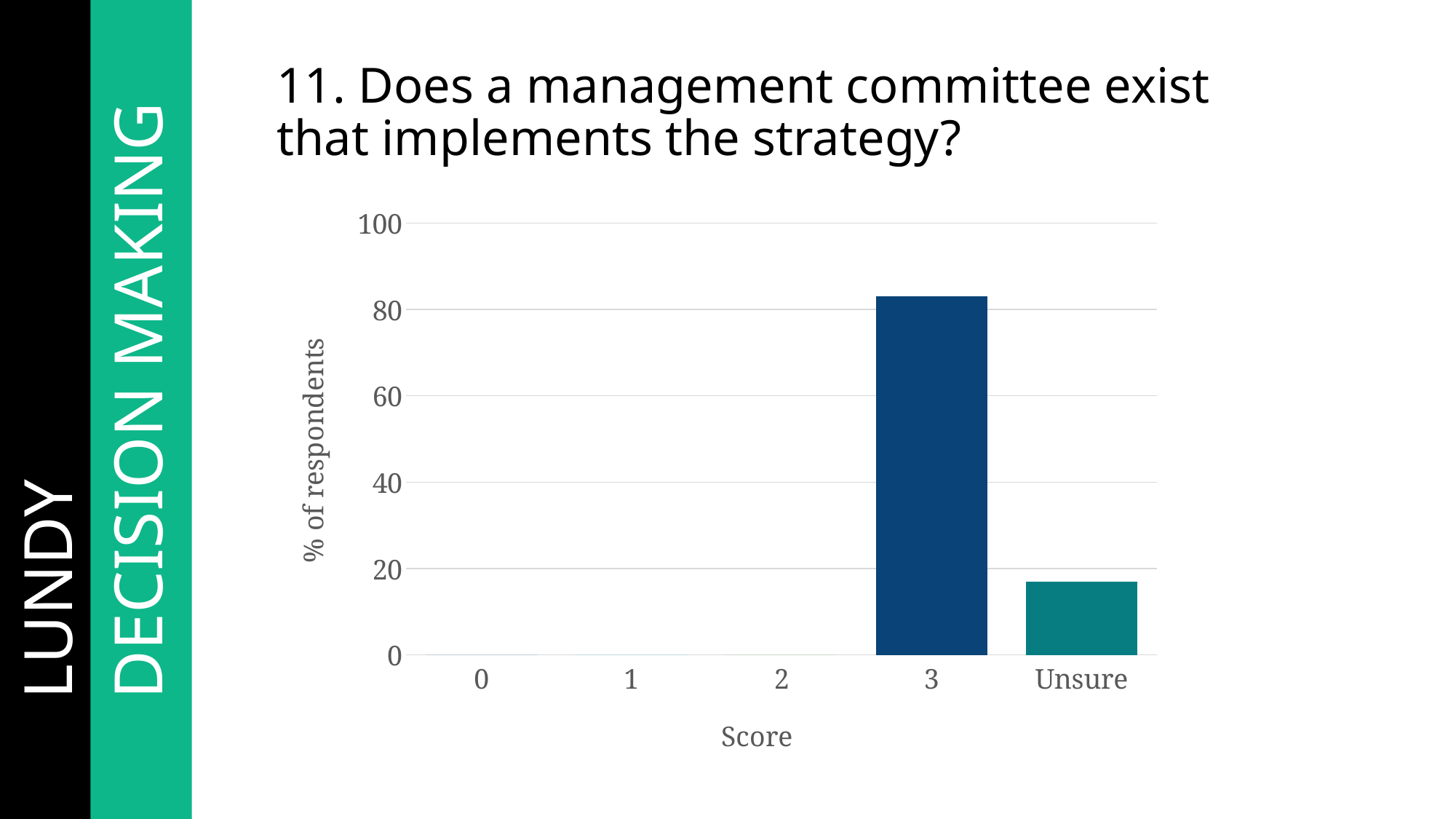
Is the value for Unsure greater or less than 40? less What is the percentage of respondents for score 0? 0 Which score category has the highest percentage of respondents? 3 Is the value for score 3 greater or less than 80? greater How many score categories are shown on the x axis? 5 What is the label of the x axis? Score What is the label of the y axis? % of respondents Is the value for Unsure greater or less than 20? less What kind of chart is shown on the slide? bar chart Which is larger, the value for score 3 or the value for Unsure? 3